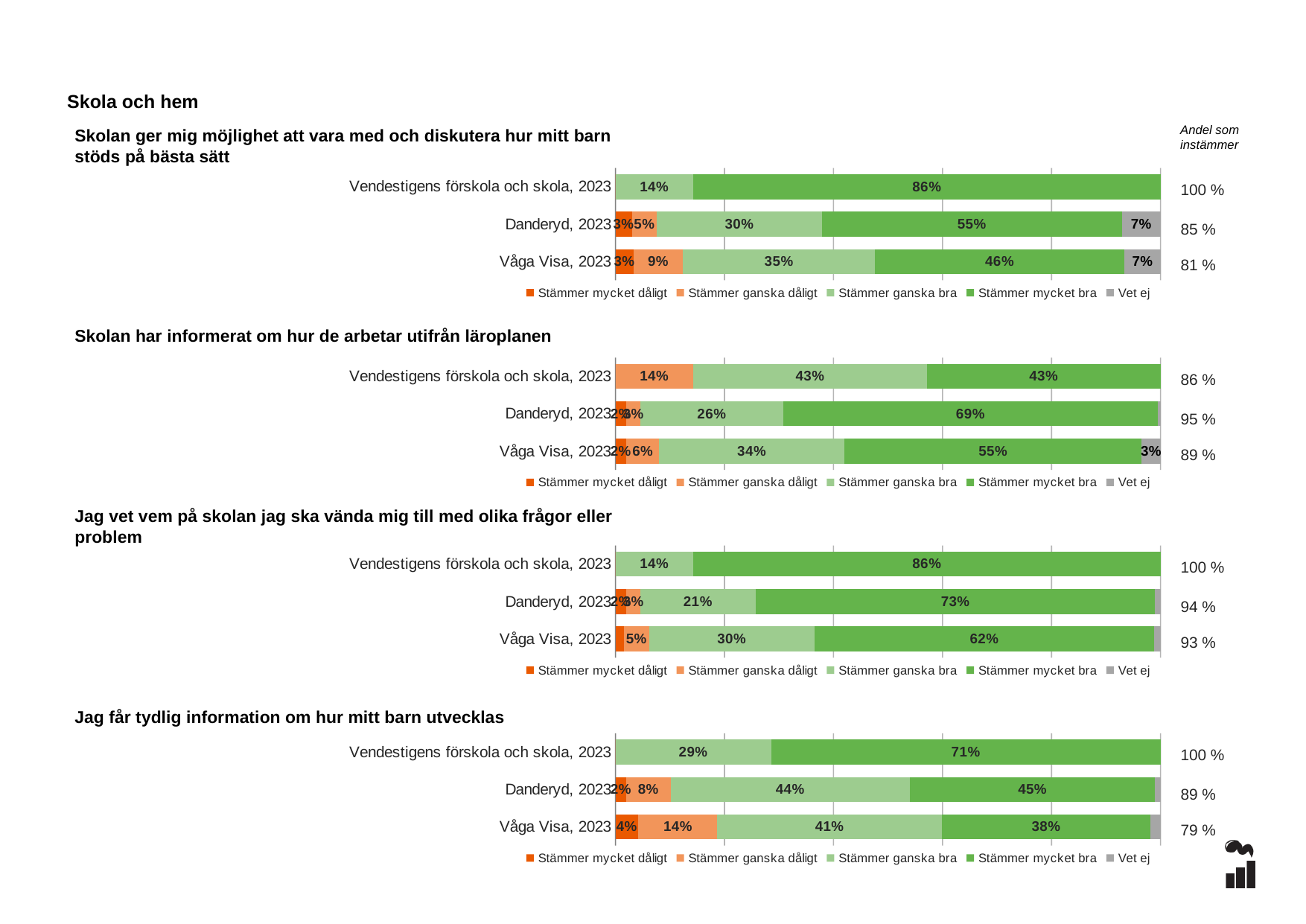
In the chart "Jag vet vem på skolan jag ska vända mig till med olika frågor eller problem", which is larger: the "Stämmer mycket bra" value for Danderyd, 2023 or for Våga Visa, 2023? Danderyd, 2023 In the chart "Skolan har informerat om hur de arbetar utifrån läroplanen", what is the difference between the "Stämmer mycket bra" values for Danderyd, 2023 and Våga Visa, 2023? 14 percentage points In the chart "Jag får tydlig information om hur mitt barn utvecklas", what is the difference between the "Stämmer mycket bra" values for Vendestigens förskola och skola, 2023 and Våga Visa, 2023? 33 percentage points In the chart "Skolan har informerat om hur de arbetar utifrån läroplanen", which row has the highest "Stämmer mycket bra" value? Danderyd, 2023 What kind of chart is "Jag får tydlig information om hur mitt barn utvecklas"? Stacked bar chart In the chart "Skolan ger mig möjlighet att vara med och diskutera hur mitt barn stöds på bästa sätt", what is the "Andel som instämmer" value for Våga Visa, 2023? 81 % In the chart "Skolan har informerat om hur de arbetar utifrån läroplanen", what is the "Stämmer ganska dåligt" value for Vendestigens förskola och skola, 2023? 14% In the chart "Skolan ger mig möjlighet att vara med och diskutera hur mitt barn stöds på bästa sätt", what is the "Stämmer mycket bra" value for Vendestigens förskola och skola, 2023? 86% In the chart "Jag får tydlig information om hur mitt barn utvecklas", what is the "Stämmer ganska bra" value for Danderyd, 2023? 44% How many series does the legend list for the chart "Skolan ger mig möjlighet att vara med och diskutera hur mitt barn stöds på bästa sätt"? 5 In the chart "Jag vet vem på skolan jag ska vända mig till med olika frågor eller problem", what is the "Stämmer ganska bra" value for Våga Visa, 2023? 30% In the chart "Jag får tydlig information om hur mitt barn utvecklas", which row has the lowest "Andel som instämmer" value? Våga Visa, 2023